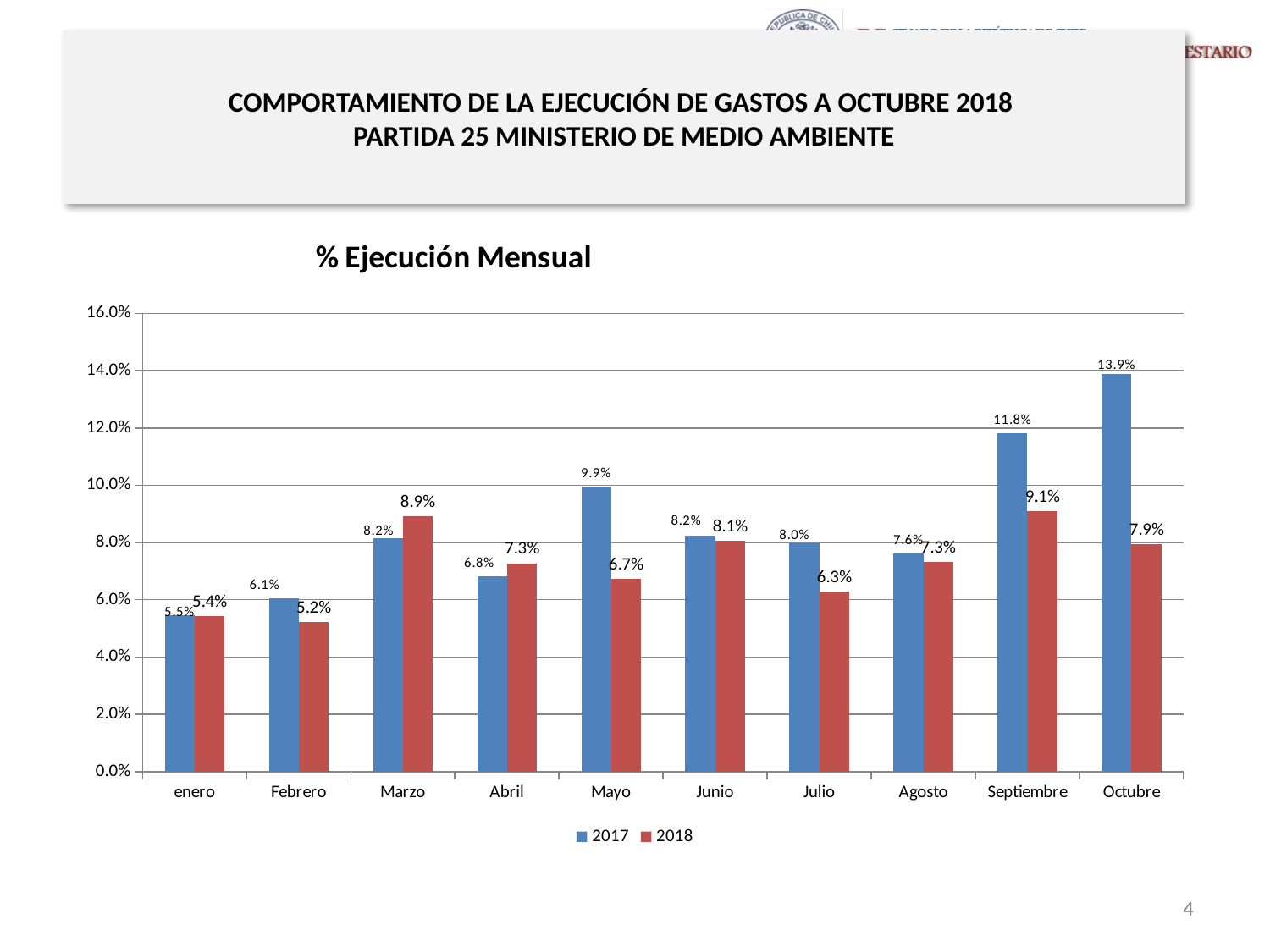
What is the value for 2017 in Octubre? 13.9% Which month has the lowest value for the 2018 series? Febrero What is the title of the chart? % Ejecución Mensual What is the difference between the 2017 and 2018 values in Septiembre? 2.7% Is the value for 2017 in Septiembre greater or less than 10.0%? greater Which month has the highest value for the 2017 series? Octubre Which is larger in Abril, the 2017 value or the 2018 value? 2018 What kind of chart is shown on the slide? bar chart What is the value for 2017 in Mayo? 9.9% What is the value for 2018 in Marzo? 8.9% How many months are shown on the x axis? 10 How many series does the legend list? 2